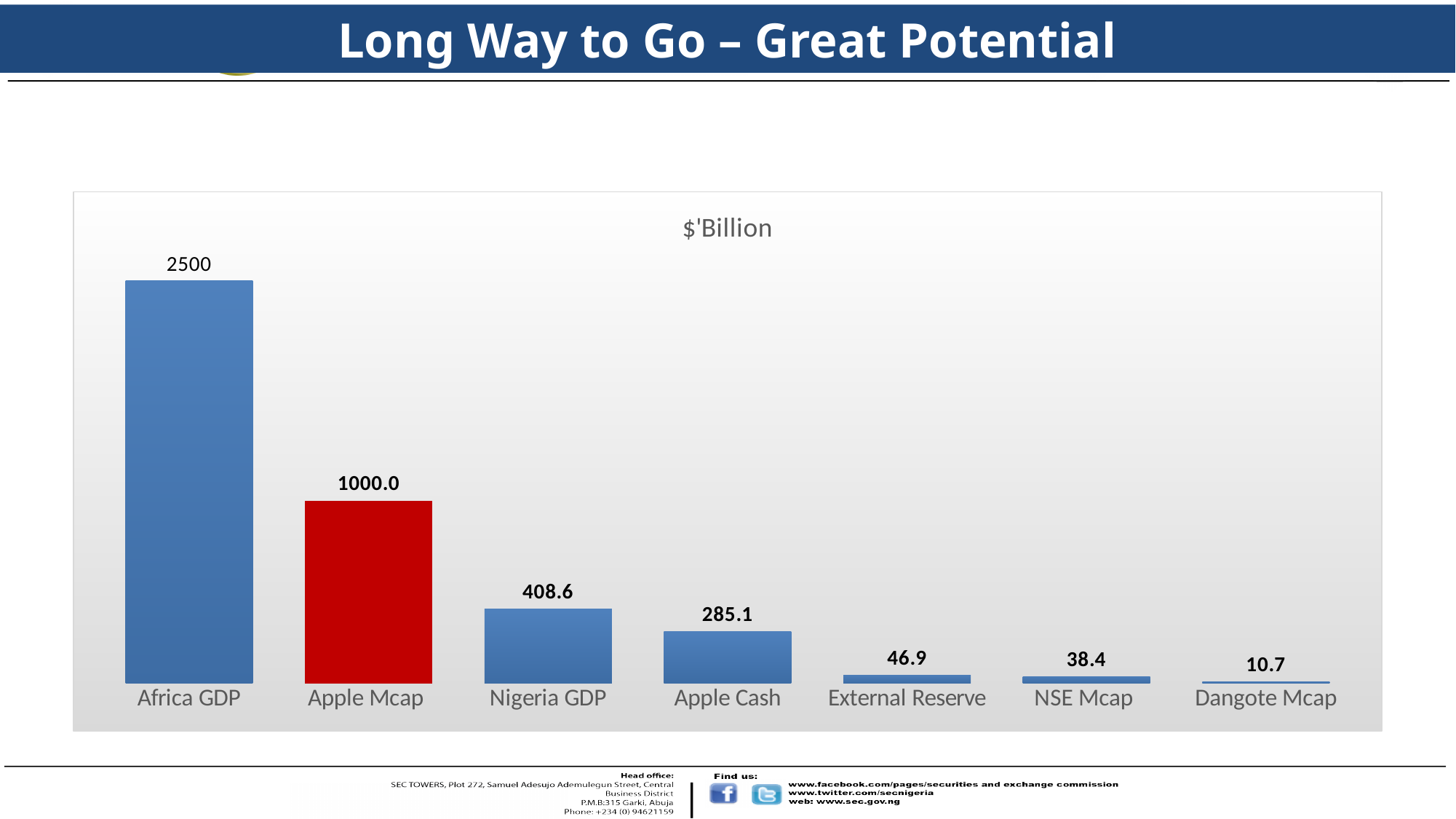
What kind of chart is shown on the slide? Bar chart What is the difference between Nigeria GDP and Apple Cash? 123.5 Which category has the lowest value? Dangote Mcap Which category has the highest value? Africa GDP What is the value for External Reserve? 46.9 What is the title of the chart? $'Billion What is the value for Apple Mcap? 1000.0 What is the value for Dangote Mcap? 10.7 What is the value for Africa GDP? 2500 How many categories are shown in the chart? 7 Which is larger, External Reserve or NSE Mcap? External Reserve What is the value for Nigeria GDP? 408.6